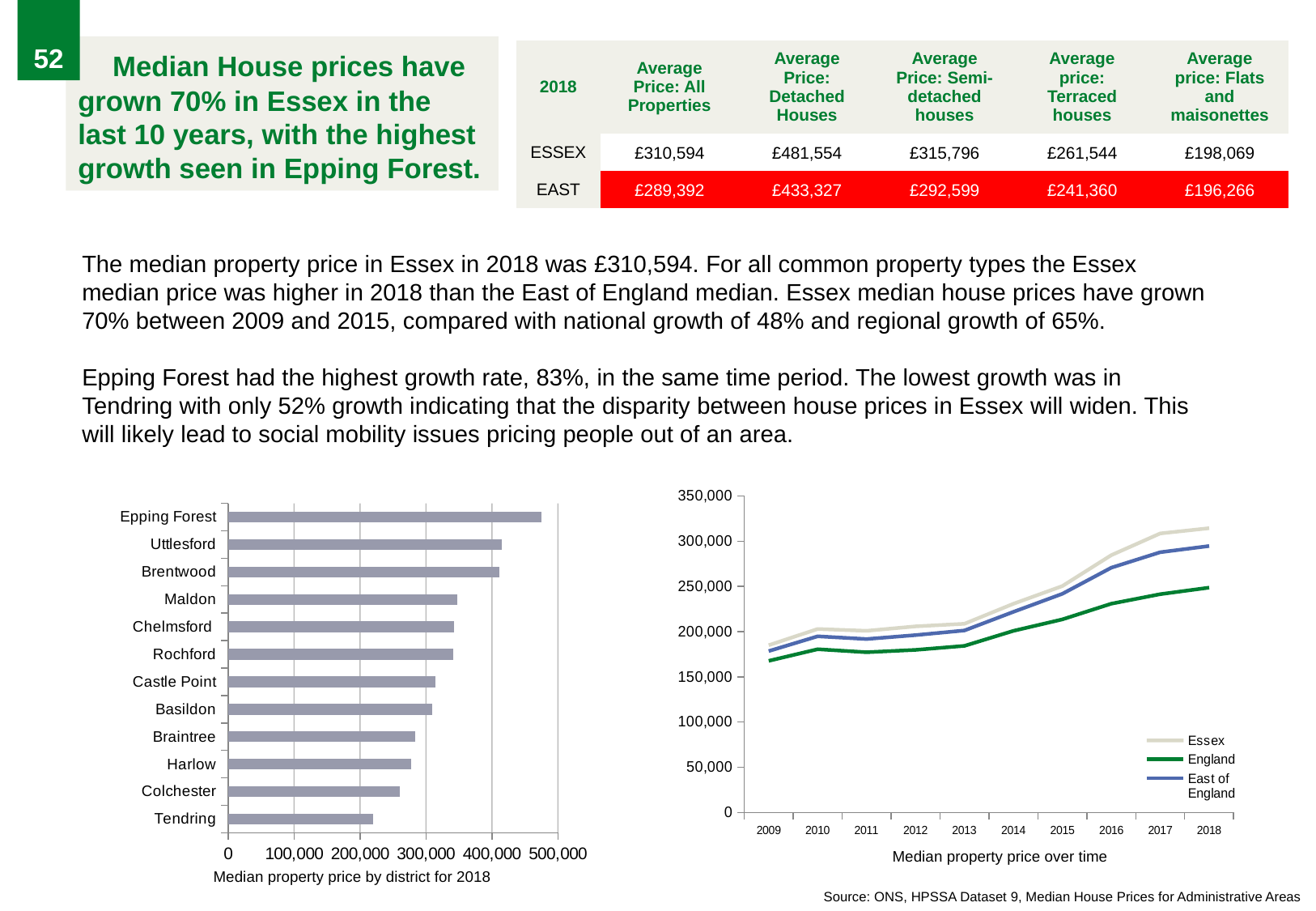
In the chart titled 'Median property price over time', is the value for Essex in 2018 greater or less than 300,000? greater In the chart titled 'Median property price by district for 2018', is the value for Tendring greater or less than 300,000? less In the chart titled 'Median property price by district for 2018', which district has the lowest median property price? Tendring In the chart titled 'Median property price over time', which series has the lowest value in 2018? England How many districts are shown in the chart titled 'Median property price by district for 2018'? 12 In the chart titled 'Median property price by district for 2018', is the value for Epping Forest greater or less than 400,000? greater In the chart titled 'Median property price by district for 2018', which has the higher median property price, Maldon or Colchester? Maldon What kind of chart is 'Median property price over time'? Line chart How many series does the legend list in the chart titled 'Median property price over time'? 3 What kind of chart is 'Median property price by district for 2018'? Bar chart In the chart titled 'Median property price by district for 2018', which district has the highest median property price? Epping Forest In the chart titled 'Median property price over time', do the values for Essex rise or fall from 2009 to 2018? Rise